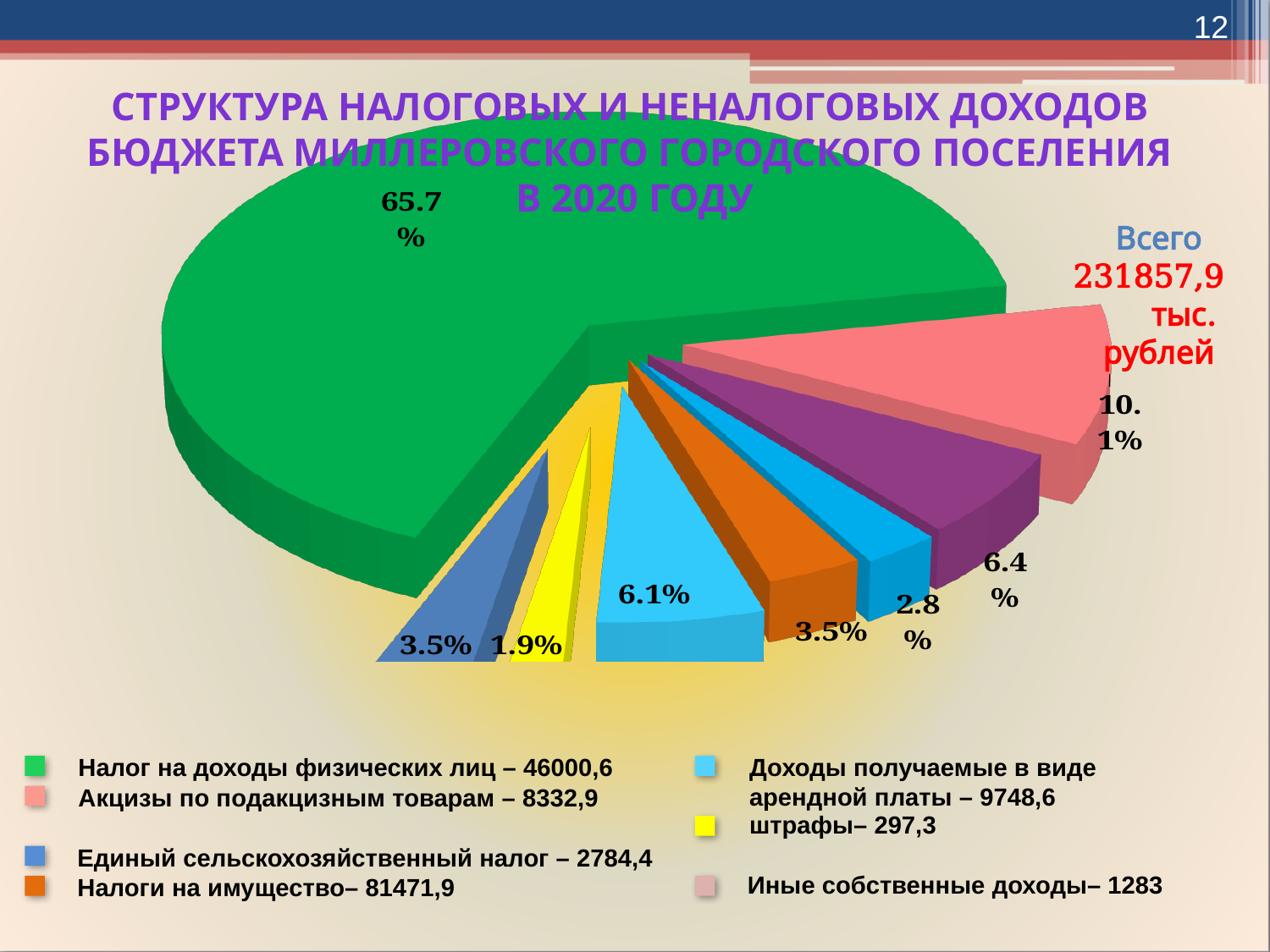
What share is labelled on the pink slice of the pie chart? 10.1% What is the share of the smallest labelled slice of the pie chart? 1.9% What total amount (Всего) is shown next to the pie chart? 231857,9 тыс. рублей What kind of chart is shown on the slide? pie chart What share is labelled on the green slice of the pie chart? 65.7% How many slices does the pie chart have? 8 What share is labelled on the purple slice of the pie chart? 6.4% What is the share of the largest slice of the pie chart? 65.7% What is the difference in percentage points between the green slice (65.7%) and the pink slice (10.1%)? 55.6 According to the legend, what is the value for Налог на доходы физических лиц? 46000,6 According to the legend, what is the value for штрафы? 297,3 Which slice is larger, the green slice or the pink slice? the green slice